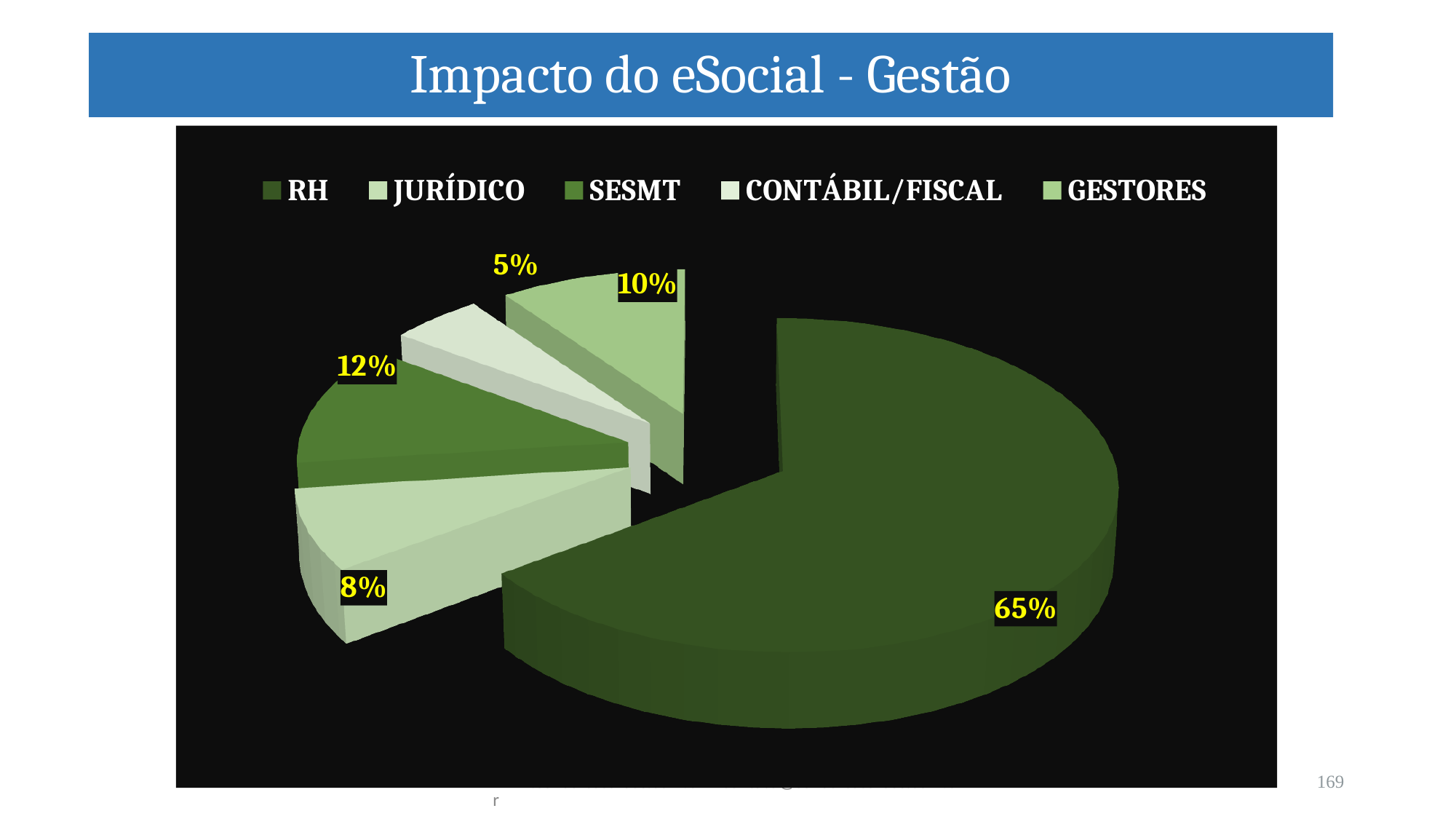
What percentage is shown for CONTÁBIL/FISCAL? 5% What is the difference between the RH share and the SESMT share? 53% Which is larger, the share for JURÍDICO or the share for GESTORES? GESTORES Which category has the smallest share of the pie? CONTÁBIL/FISCAL What percentage is shown for GESTORES? 10% What percentage is shown for SESMT? 12% What percentage is shown for RH? 65% How many entries does the legend list? 5 Which category has the largest share of the pie? RH What is the title of the slide containing the chart? Impacto do eSocial - Gestão How many slices does the pie chart have? 5 What kind of chart is shown on the slide? pie chart